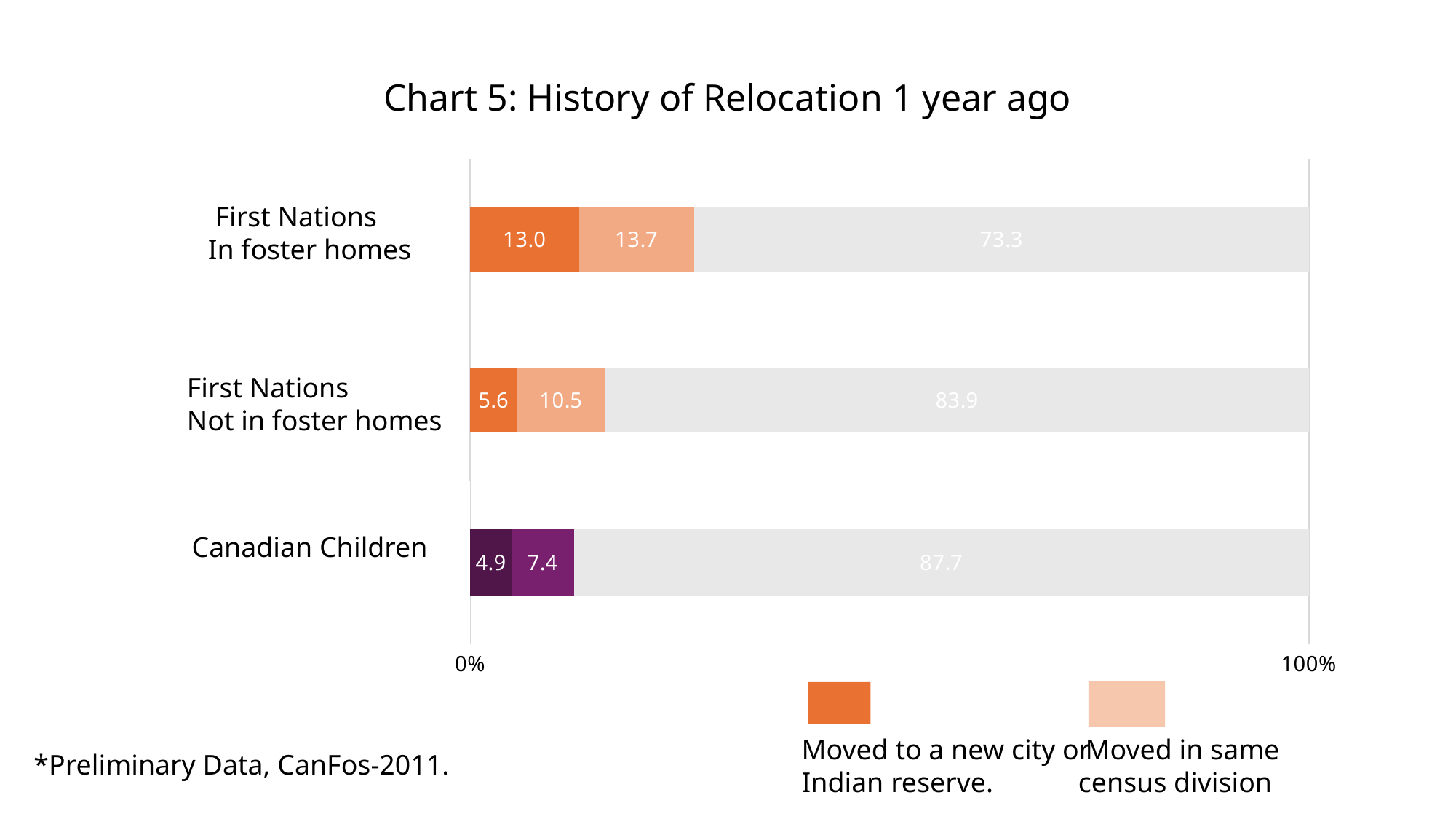
Which category has the lowest value for 'Moved in same census division'? Canadian Children Which is larger: the 'Moved in same census division' value for First Nations In foster homes or for First Nations Not in foster homes? First Nations In foster homes What is the combined value of the two labelled 'moved' segments for First Nations Not in foster homes? 16.1 What is the value for 'Moved to a new city or Indian reserve' for First Nations In foster homes? 13.0 Which category has the highest value for 'Moved to a new city or Indian reserve'? First Nations In foster homes How many series does the legend list? 2 How many categories are shown on the chart? 3 What is the value of the grey segment for Canadian Children? 87.7 What is the difference between the 'Moved to a new city or Indian reserve' values for First Nations In foster homes and Canadian Children? 8.1 What kind of chart is shown? Stacked bar chart What is the title of the chart? Chart 5: History of Relocation 1 year ago What is the value for 'Moved in same census division' for First Nations Not in foster homes? 10.5